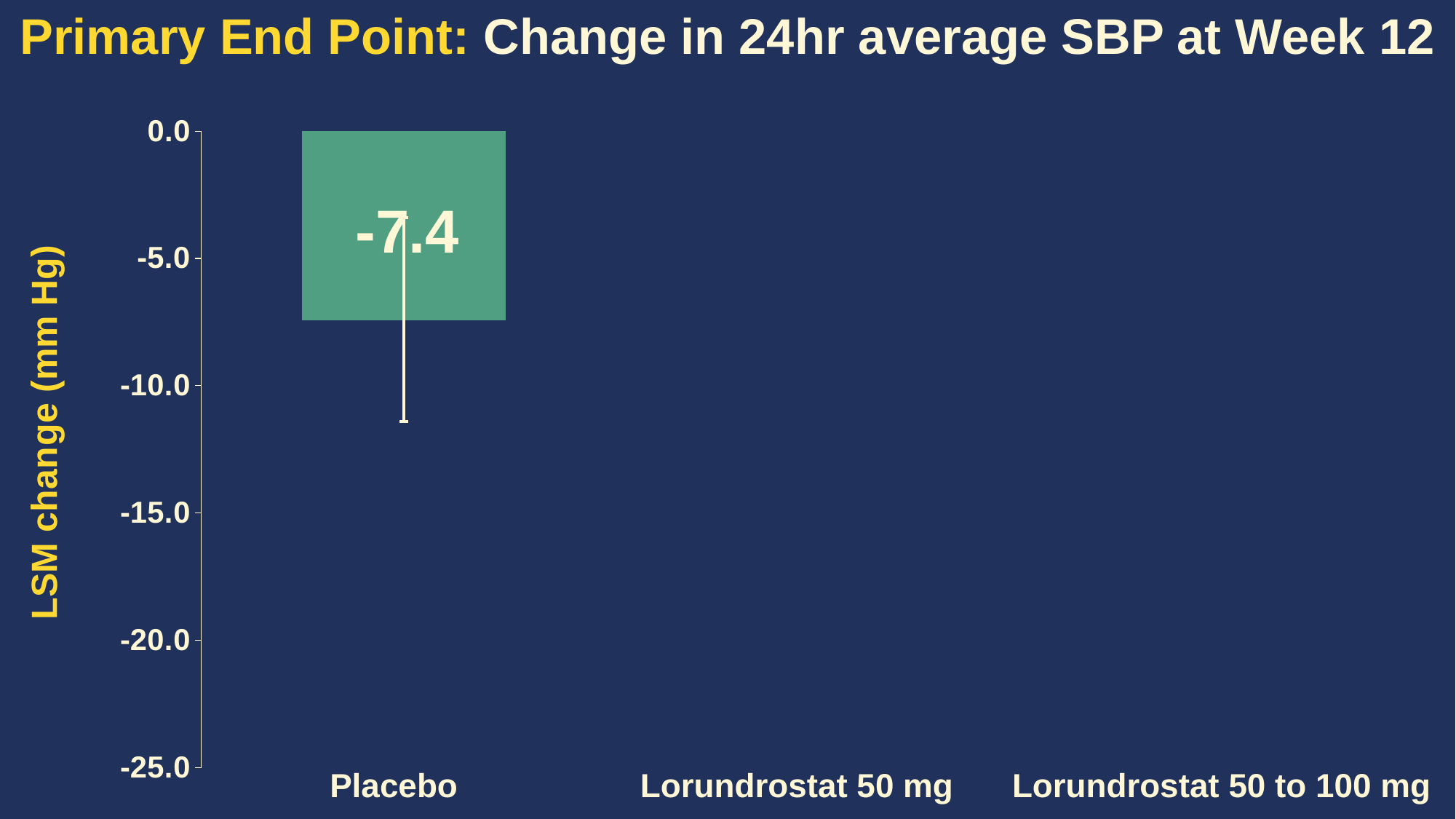
Which category has a bar plotted on the chart? Placebo How many category labels are shown along the x axis? 3 How many bars are actually plotted on the chart? 1 What is the LSM change in 24hr average SBP for the Placebo group? -7.4 What is the label of the y axis? LSM change (mm Hg) What kind of chart is shown on the slide? bar chart What is the unit of the values on the y axis? mm Hg Is the value for Placebo greater or less than -5.0? less Is the value for Placebo greater or less than -10.0? greater